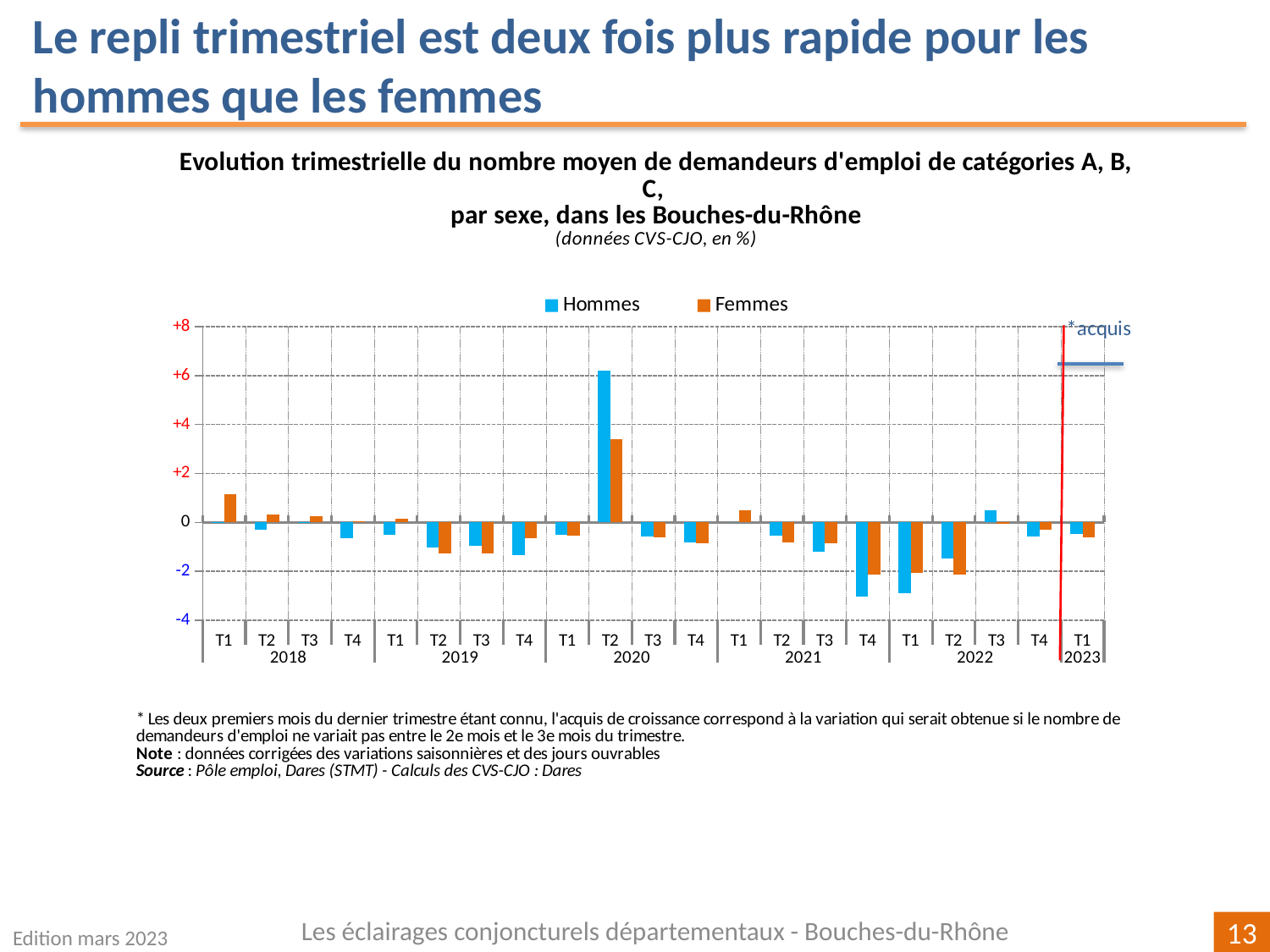
In which quarter is the Hommes value highest? T2 2020 What are the two series named in the legend? Hommes and Femmes What kind of chart is shown on the slide? bar chart How many series does the legend list? 2 In which quarter is the Femmes value highest? T2 2020 Is the Hommes value for T4 2021 greater or less than -2? less Is the Hommes value for T2 2020 greater or less than +4? greater In T2 2020, which series has the larger value, Hommes or Femmes? Hommes Is the Femmes value for T2 2020 greater or less than +2? greater Which colour represents the Hommes series? blue How many quarters are plotted along the x axis? 21 In T1 2018, which series has the larger value, Hommes or Femmes? Femmes